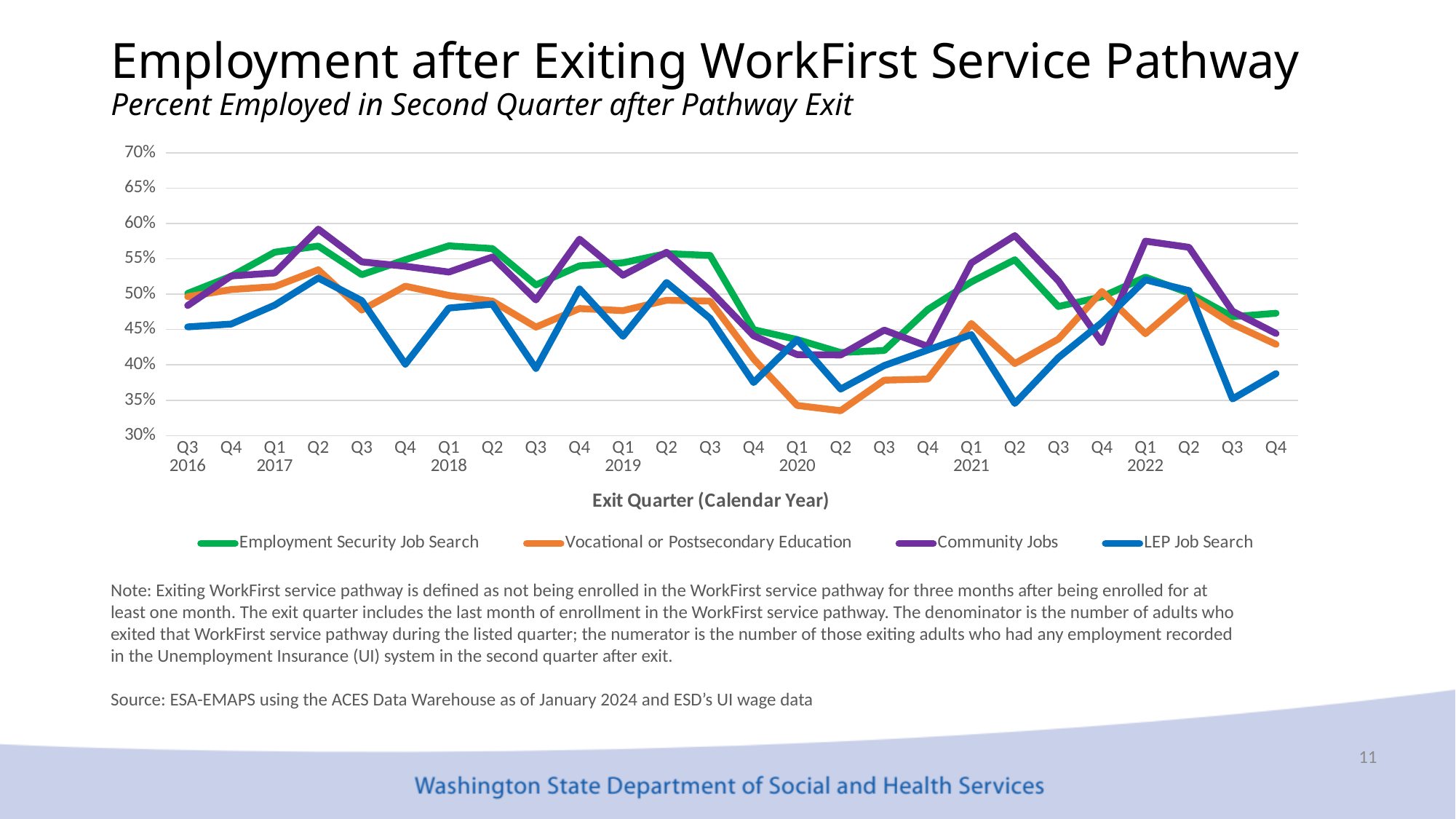
What kind of chart is shown on the slide? Line chart In Q3 2022, which is larger: Community Jobs or LEP Job Search? Community Jobs Does the LEP Job Search line rise or fall from Q1 2022 to Q3 2022? Fall Is the value for LEP Job Search in Q4 2019 greater or less than 40%? less What is the title of the x axis? Exit Quarter (Calendar Year) Which series has the lowest value in Q2 2020? Vocational or Postsecondary Education How many series does the legend list? 4 Is the value for LEP Job Search in Q3 2022 greater or less than 40%? less Which series has the highest value in Q2 2017? Community Jobs Is the value for Community Jobs in Q2 2017 greater or less than 55%? greater How many exit quarters are plotted along the x axis? 26